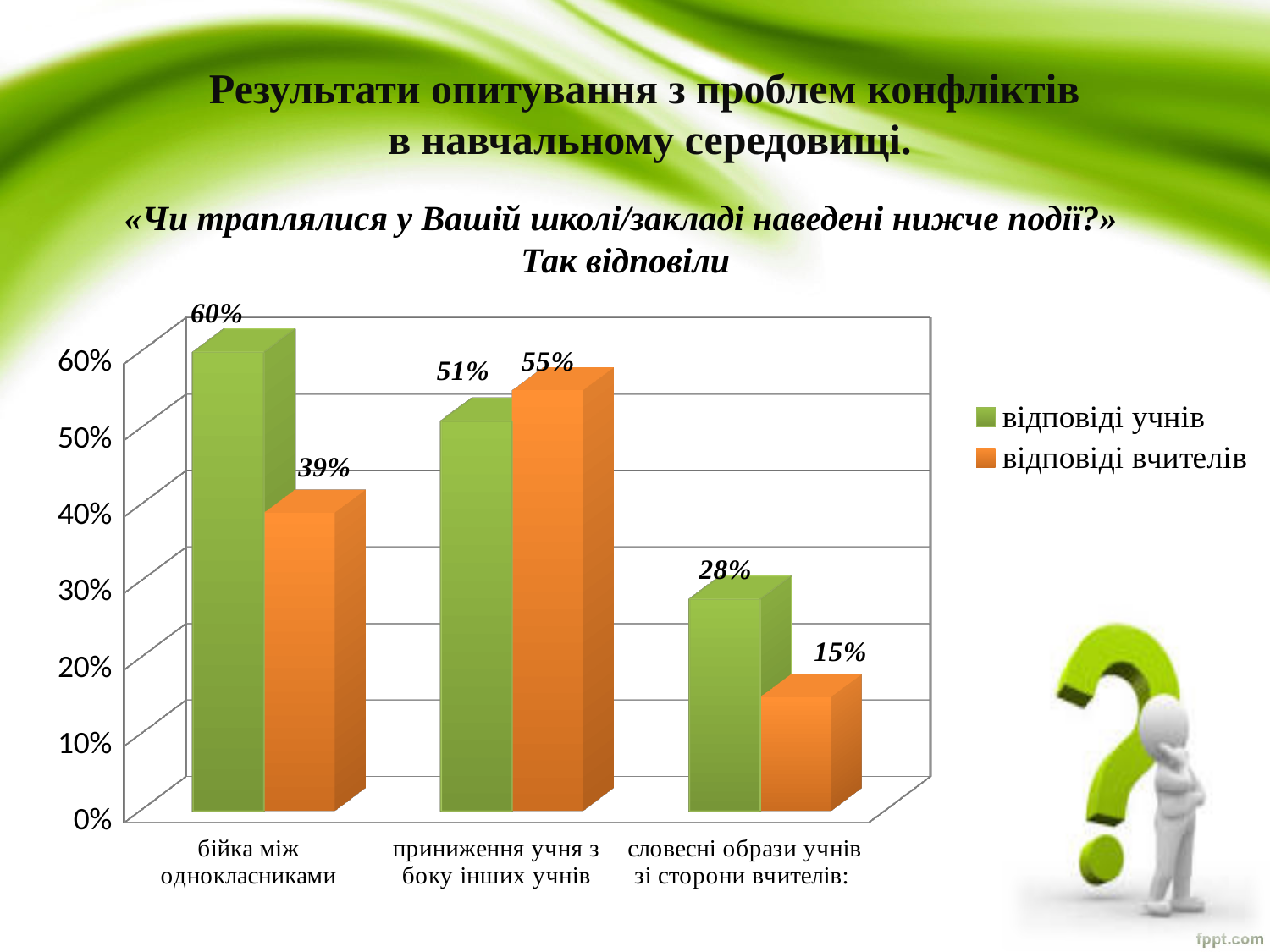
How many categories are shown on the x axis of the chart? 3 What is the value for 'відповіді вчителів' in the category 'словесні образи учнів зі сторони вчителів'? 15% How many series does the legend list? 2 Is the value for 'відповіді учнів' in 'словесні образи учнів зі сторони вчителів' greater or less than 30%? less What percentage of students (відповіді учнів) answered yes for 'бійка між однокласниками'? 60% Which category has the lowest value for 'відповіді вчителів'? словесні образи учнів зі сторони вчителів For 'приниження учня з боку інших учнів', which series has the larger value: 'відповіді учнів' or 'відповіді вчителів'? відповіді вчителів What is the difference between the students' and teachers' values for 'бійка між однокласниками'? 21% Which category has the highest value for 'відповіді учнів'? бійка між однокласниками Which colour represents 'відповіді вчителів' in the chart? orange What type of chart is shown on the slide? bar chart What percentage of teachers (відповіді вчителів) answered yes for 'приниження учня з боку інших учнів'? 55%